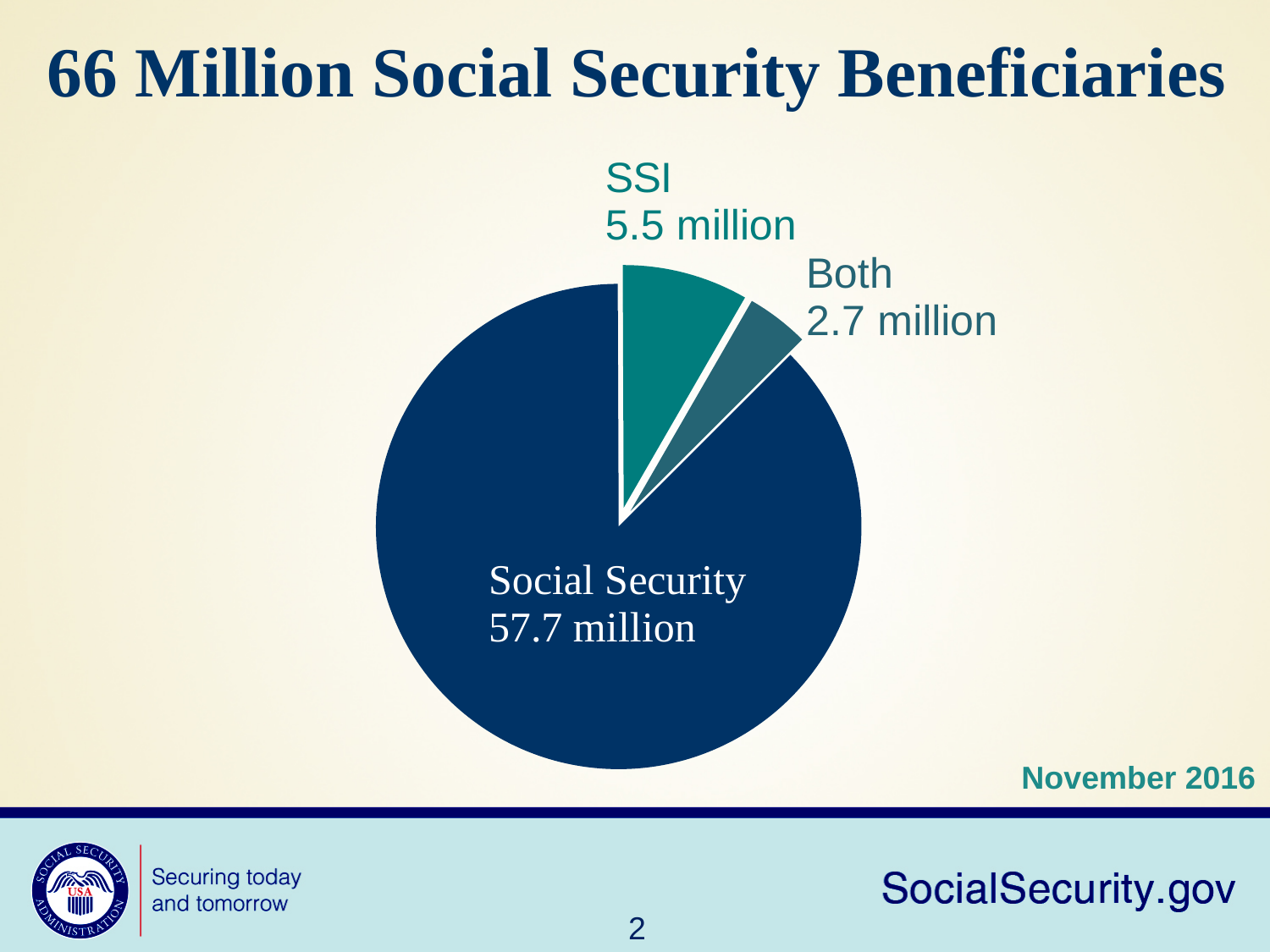
What is the sum of the three slice values shown on the pie chart? 65.9 million How many slices does the pie chart have? 3 How much larger is the SSI value than the Both value? 2.8 million How many beneficiaries are shown for the Social Security slice of the pie chart? 57.7 million Which slice of the pie chart is the largest? Social Security Which is larger, the SSI slice or the Both slice? SSI What value is shown for the SSI slice? 5.5 million What value is shown for the Both slice? 2.7 million Which slice of the pie chart is the smallest? Both What is the title of the slide containing the pie chart? 66 Million Social Security Beneficiaries What is the difference between the Social Security value and the SSI value? 52.2 million What kind of chart is shown on the slide? Pie chart